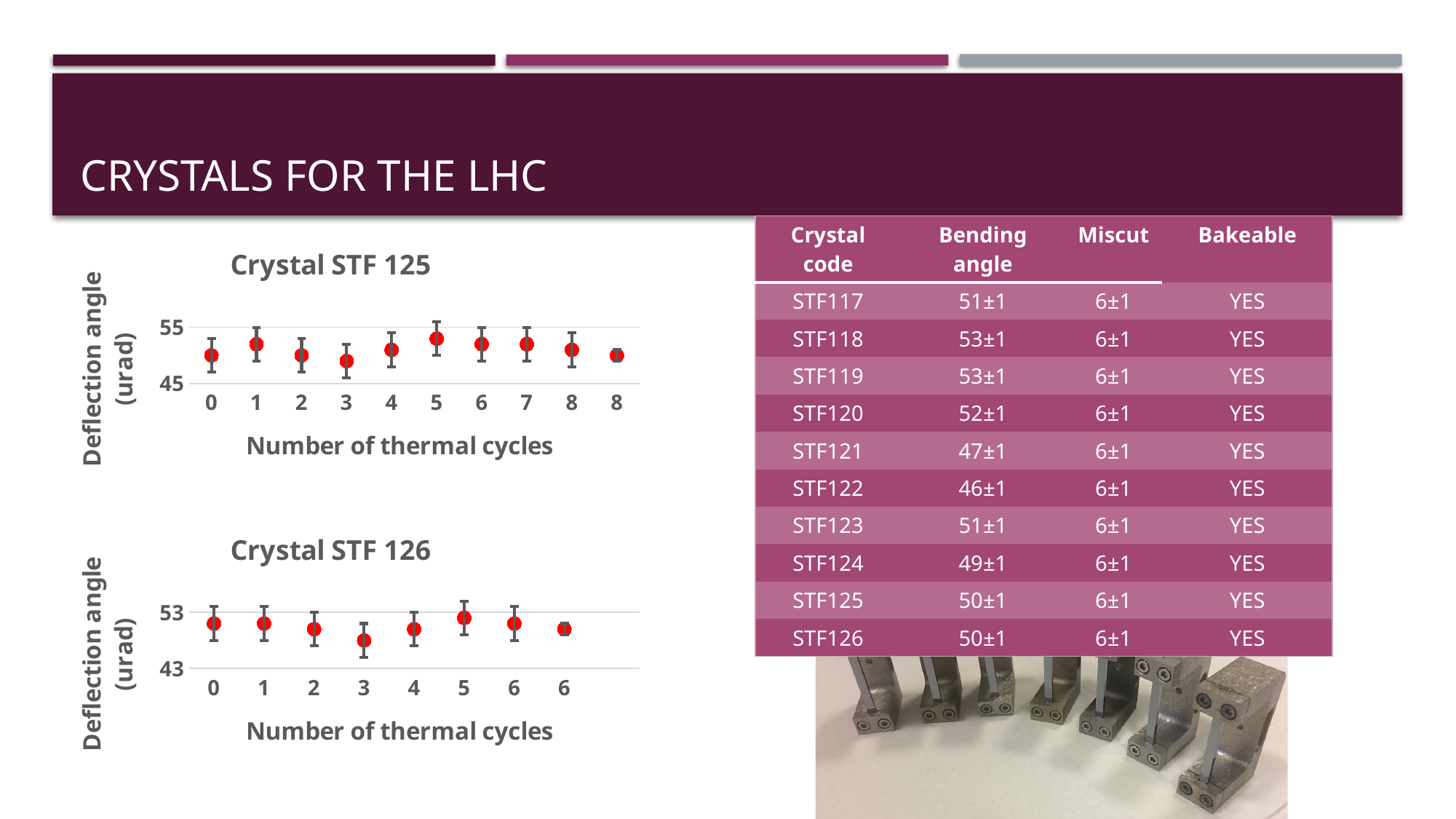
In the 'Crystal STF 125' chart, at which number of thermal cycles is the deflection angle lowest? 3 In the 'Crystal STF 126' chart, is the deflection angle at 3 thermal cycles larger or smaller than at 5 thermal cycles? smaller What is the x-axis label of the 'Crystal STF 125' chart? Number of thermal cycles In the 'Crystal STF 125' chart, is the deflection angle at 5 thermal cycles greater or less than 45? greater In the 'Crystal STF 126' chart, at which number of thermal cycles is the deflection angle lowest? 3 What is the y-axis label of the 'Crystal STF 126' chart? Deflection angle (urad) What kind of chart is the 'Crystal STF 125' chart? scatter chart In the 'Crystal STF 125' chart, is the deflection angle at 3 thermal cycles greater or less than 55? less In the 'Crystal STF 126' chart, is the deflection angle at 3 thermal cycles greater or less than 43? greater How many data points are plotted in the 'Crystal STF 125' chart? 10 In the 'Crystal STF 126' chart, at which number of thermal cycles is the deflection angle highest? 5 How many data points are plotted in the 'Crystal STF 126' chart? 8